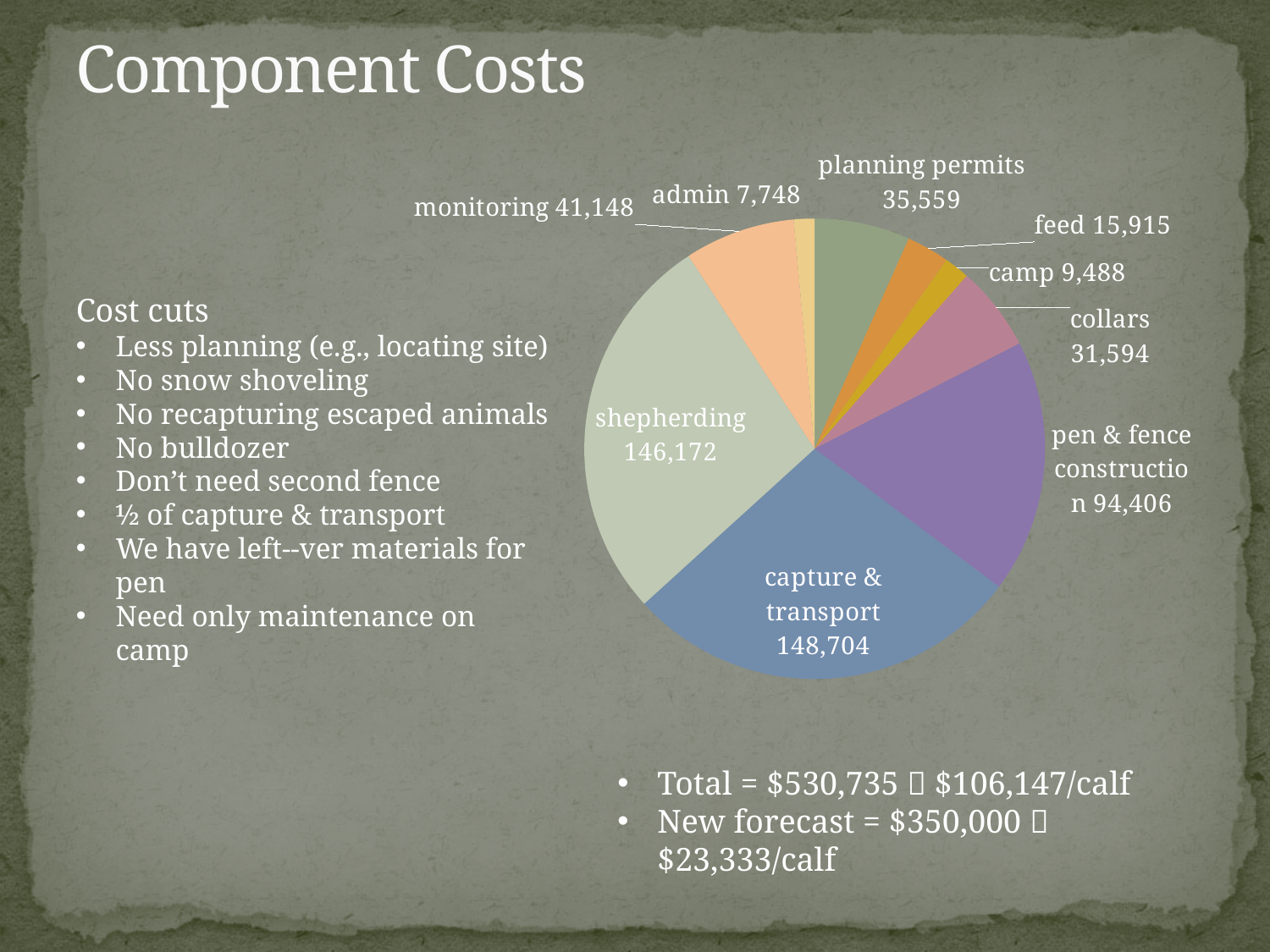
What type of chart is shown on the slide? pie chart What is the value for collars? 31,594 What is the difference between the capture & transport cost and the shepherding cost? 2,532 What is the value for camp? 9,488 What is the value for shepherding in the pie chart? 146,172 Which component has the smallest cost in the pie chart? admin How many components (slices) are shown in the pie chart? 9 What is the value for pen & fence construction? 94,406 Which component has the largest cost in the pie chart? capture & transport Which is larger, the cost for monitoring or the cost for planning permits? monitoring What is the difference between the pen & fence construction cost and the collars cost? 62,812 What is the title of the slide containing the pie chart? Component Costs